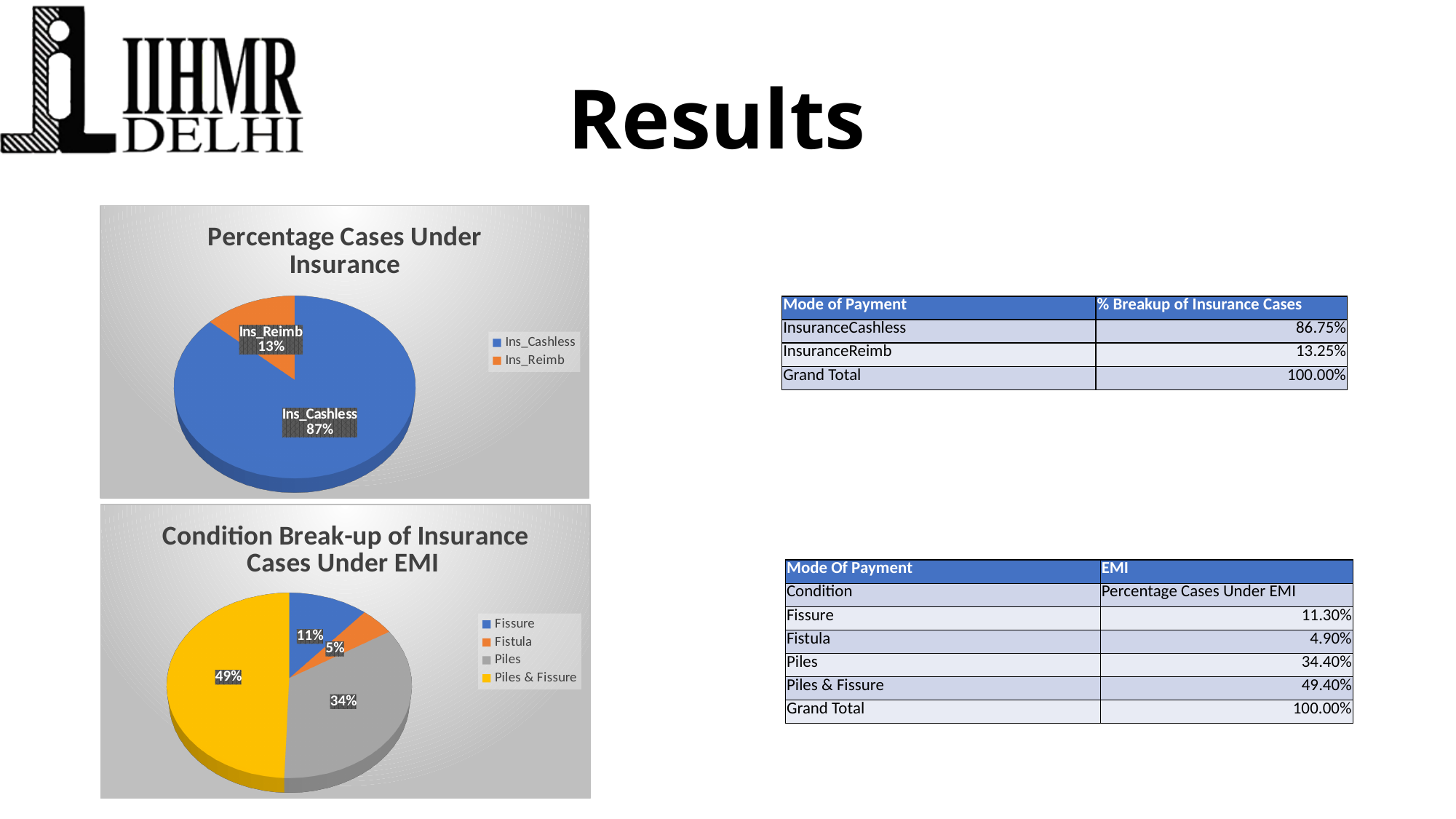
In the 'Percentage Cases Under Insurance' chart, what percentage is shown for Ins_Reimb? 13% In the 'Condition Break-up of Insurance Cases Under EMI' chart, what percentage is shown for Piles? 34% In the 'Condition Break-up of Insurance Cases Under EMI' chart, what percentage is shown for Fistula? 5% How many categories does the legend of the 'Percentage Cases Under Insurance' chart list? 2 In the 'Percentage Cases Under Insurance' chart, what percentage is shown for Ins_Cashless? 87% In the 'Percentage Cases Under Insurance' chart, which category has the largest slice? Ins_Cashless In the 'Condition Break-up of Insurance Cases Under EMI' chart, which condition has the smallest share? Fistula How many categories does the legend of the 'Condition Break-up of Insurance Cases Under EMI' chart list? 4 In the 'Condition Break-up of Insurance Cases Under EMI' chart, what colour is the Piles & Fissure slice? Yellow What kind of chart is 'Percentage Cases Under Insurance'? Pie chart In the 'Condition Break-up of Insurance Cases Under EMI' chart, which condition has the largest share? Piles & Fissure In the 'Condition Break-up of Insurance Cases Under EMI' chart, what is the difference in percentage points between Piles & Fissure and Piles? 15